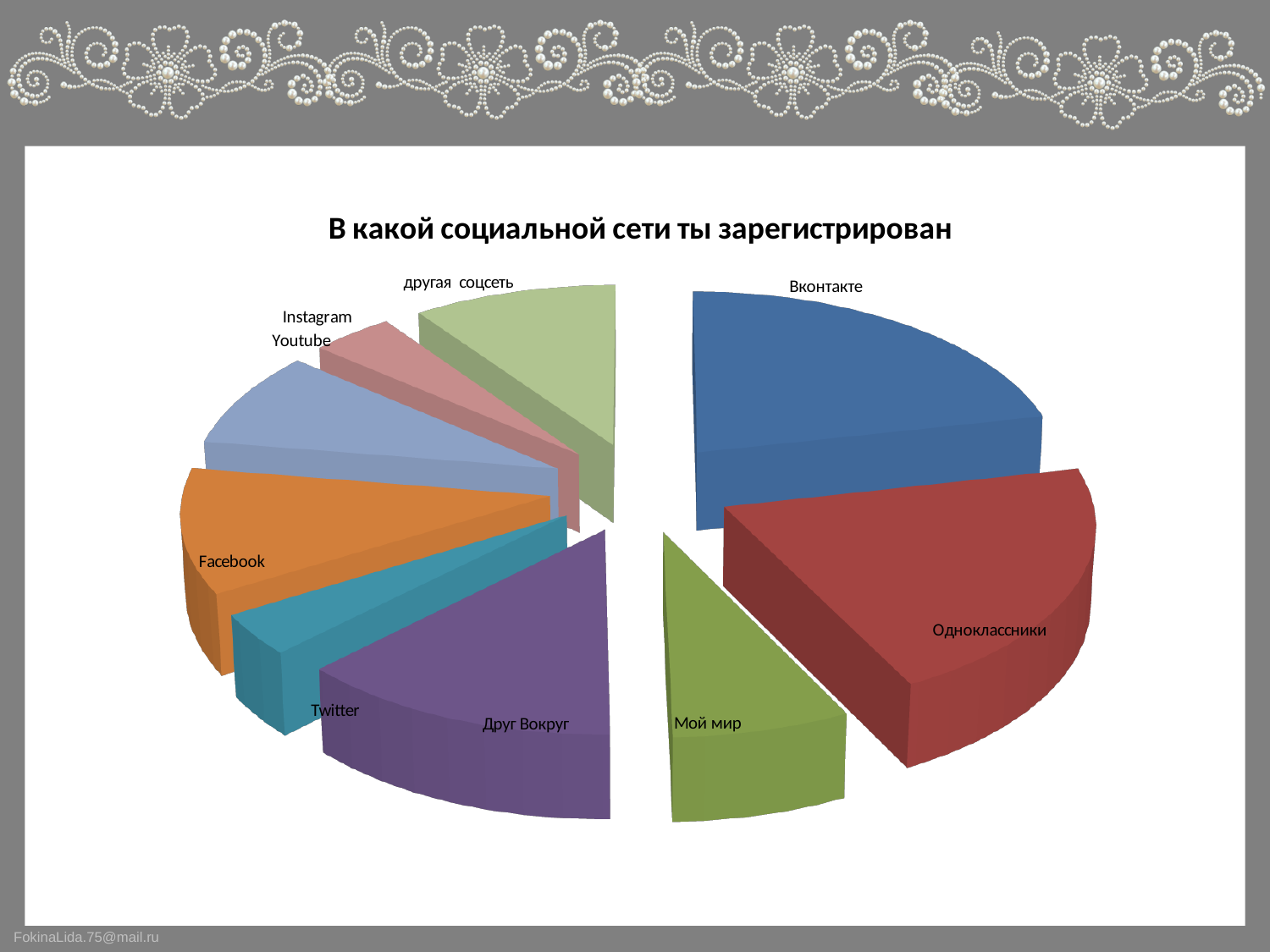
Which slice is larger, Одноклассники or Youtube? Одноклассники What colour is the Вконтакте slice? blue What is the title of the chart? В какой социальной сети ты зарегистрирован What kind of chart is shown on the slide? pie chart Which slice is larger, Facebook or Instagram? Facebook Which slice is larger, Друг Вокруг or Twitter? Друг Вокруг How many slices (categories) does the pie chart have? 9